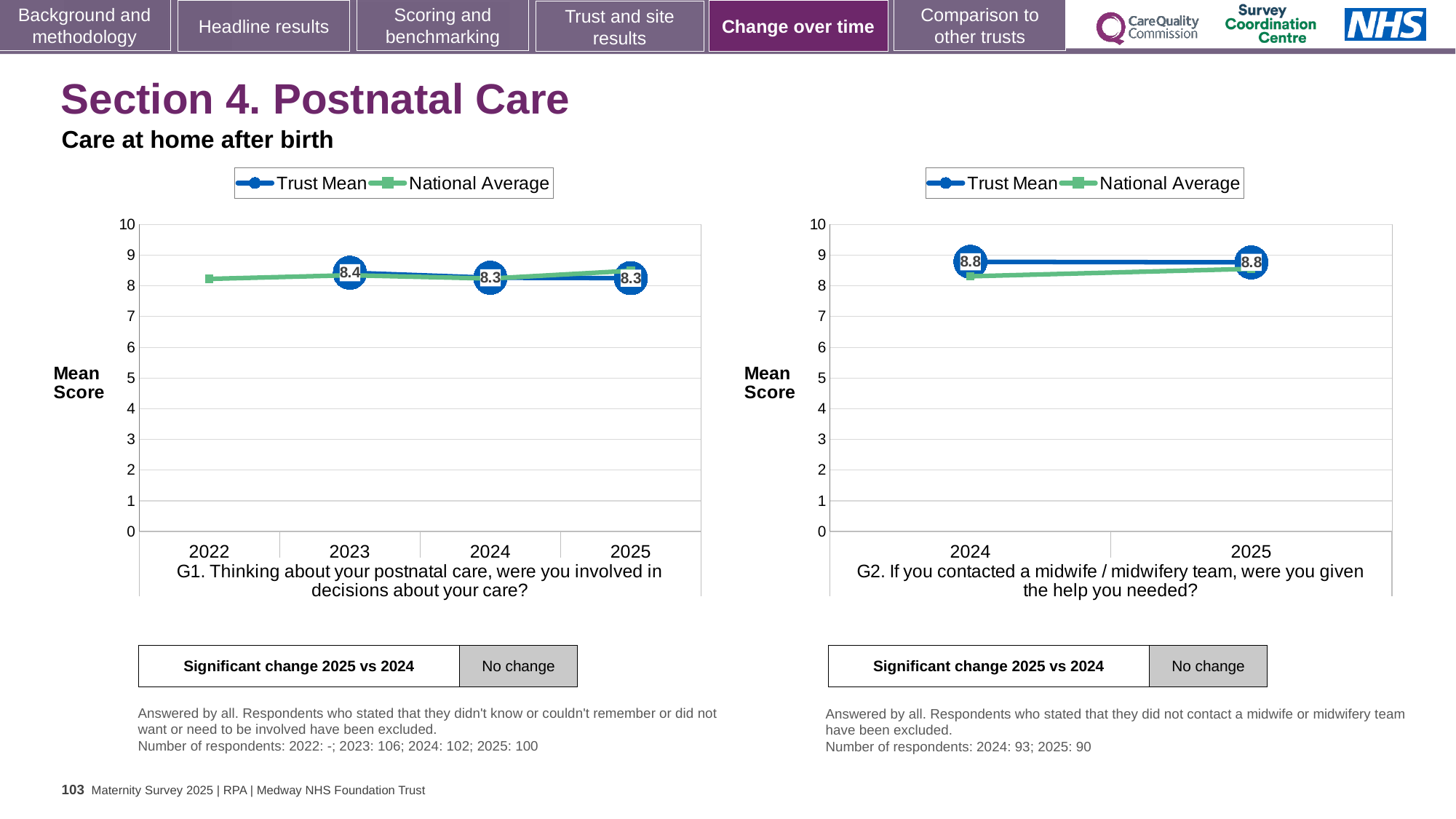
In the G2 chart on the right, is the National Average for 2024 greater or less than 9? less In the G1 chart on the left, which year has the highest Trust Mean? 2023 In the G1 chart on the left, what is the difference between the Trust Mean for 2023 and the Trust Mean for 2024? 0.1 In the G1 chart on the left, does the Trust Mean rise or fall from 2023 to 2024? fall In the G2 chart on the right, is the Trust Mean for 2024 higher or lower than the National Average for 2024? higher In the G1 chart on the left, what is the Trust Mean for 2023? 8.4 In the G2 chart on the right, what is the Trust Mean for 2024? 8.8 How many years are shown on the x axis of the G1 chart on the left? 4 In the G1 chart on the left, what is the Trust Mean for 2025? 8.3 In the G2 chart on the right, what is the Trust Mean for 2025? 8.8 What kind of chart is the G1 chart on the left? line chart How many series does the legend of the G2 chart on the right list? 2